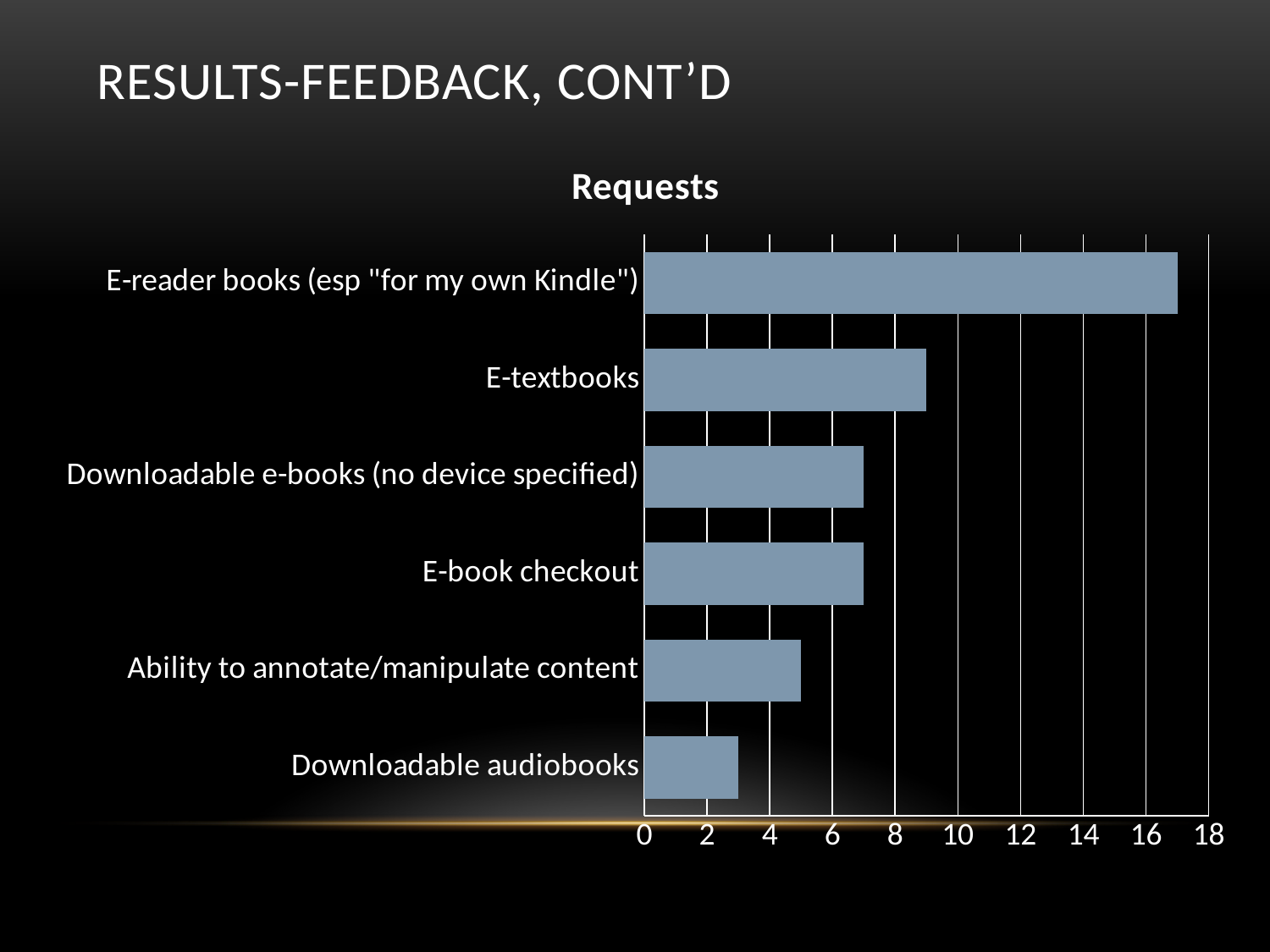
How many categories are shown in the chart? 6 Which category has the highest value? E-reader books (esp "for my own Kindle") What is the title of the chart? Requests What kind of chart is shown on the slide? bar chart Is the value for E-textbooks greater or less than 8? greater Which category has the lowest value? Downloadable audiobooks Which is larger, the value for Ability to annotate/manipulate content or the value for Downloadable audiobooks? Ability to annotate/manipulate content Is the value for E-reader books (esp "for my own Kindle") greater or less than 16? greater Is the value for Ability to annotate/manipulate content greater or less than 6? less Which is larger, the value for E-textbooks or the value for Downloadable e-books (no device specified)? E-textbooks